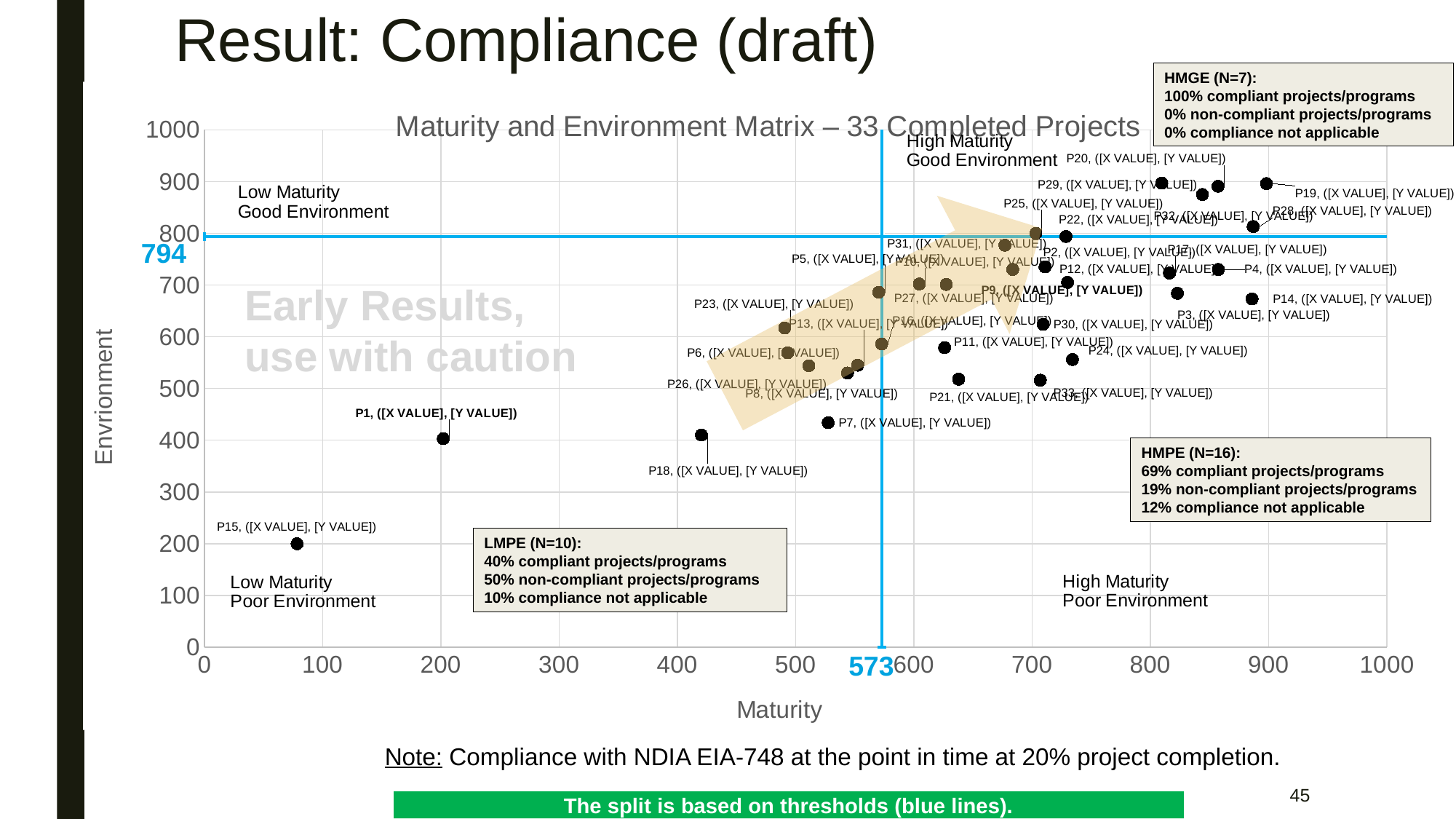
Is the Environment value for P19 greater or less than 800? greater Which project has the lowest Environment value in the chart? P15 Is the Environment value for P1 greater or less than 500? less What Environment value does the horizontal blue threshold line mark? 794 Which project has the lowest Maturity value in the chart? P15 What is the label of the vertical axis of the chart? Environment Is the Environment value for P15 greater or less than 300? less How many completed projects are plotted in the chart, according to its title? 33 What Maturity value does the vertical blue threshold line mark? 573 What is the title of the chart? Maturity and Environment Matrix – 33 Completed Projects What kind of chart is shown on the slide? Scatter chart